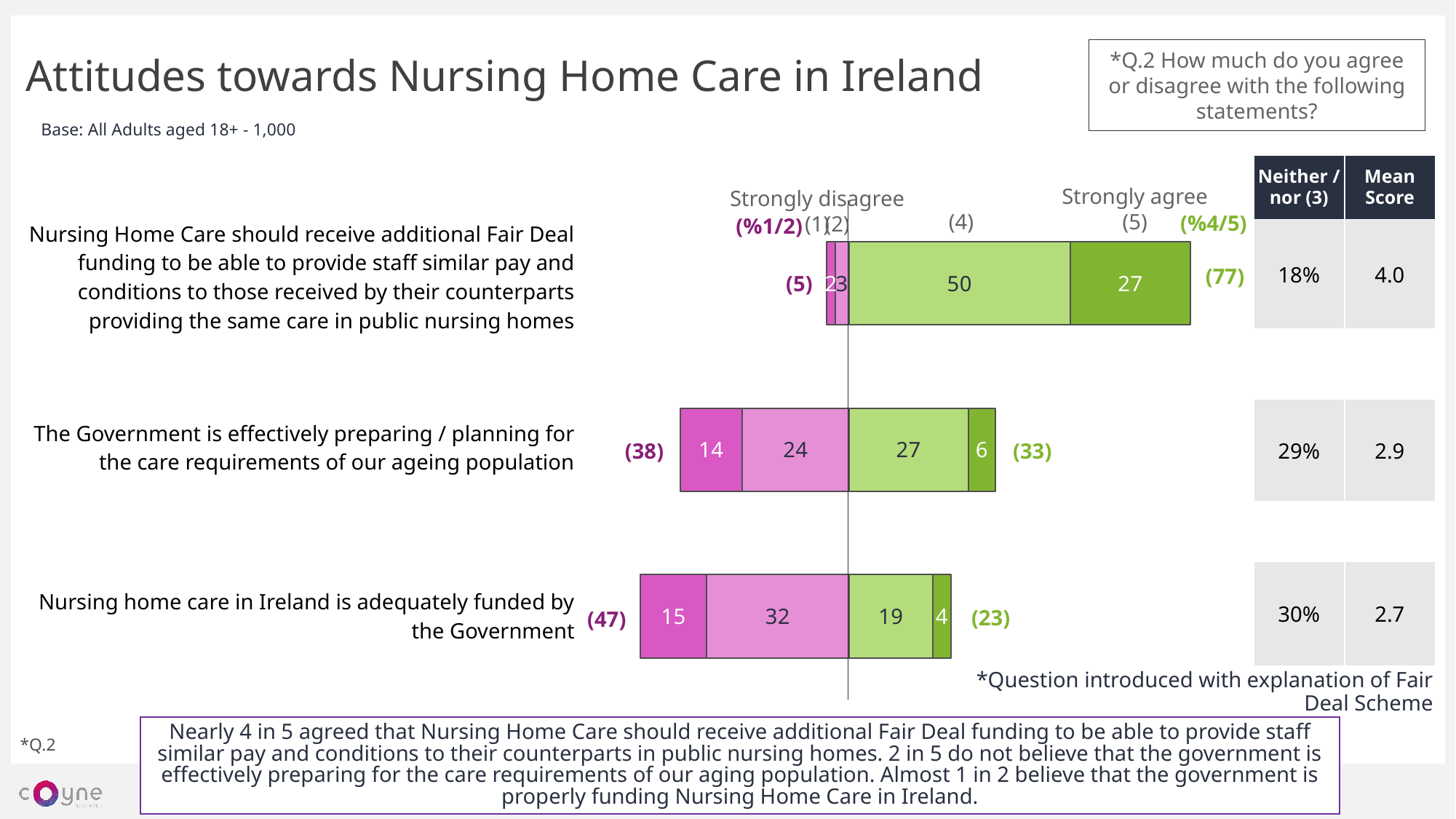
What is the difference between the agree (4) value and the strongly agree (5) value for the statement that nursing home care in Ireland is adequately funded by the Government? 15 What percentage agree (4) with the statement that Nursing Home Care should receive additional Fair Deal funding? 50 Which statement has the lowest combined agree (%4/5) figure? Nursing home care in Ireland is adequately funded by the Government What is the Mean Score for the statement that the Government is effectively preparing / planning for the care requirements of our ageing population? 2.9 What is the combined disagree (%1/2) figure for the statement that nursing home care in Ireland is adequately funded by the Government? (47) What kind of chart is shown on the slide? bar chart What is the Neither / nor (3) percentage for the statement that nursing home care in Ireland is adequately funded by the Government? 30% What percentage strongly disagree (1) with the statement that the Government is effectively preparing / planning for the care requirements of our ageing population? 14 How many statements are plotted in the chart? 3 What is the combined agree (%4/5) figure for the statement that Nursing Home Care should receive additional Fair Deal funding? (77) Is the disagree (2) value larger for the statement about the Government effectively preparing for the ageing population or for the statement that nursing home care is adequately funded by the Government? Nursing home care in Ireland is adequately funded by the Government